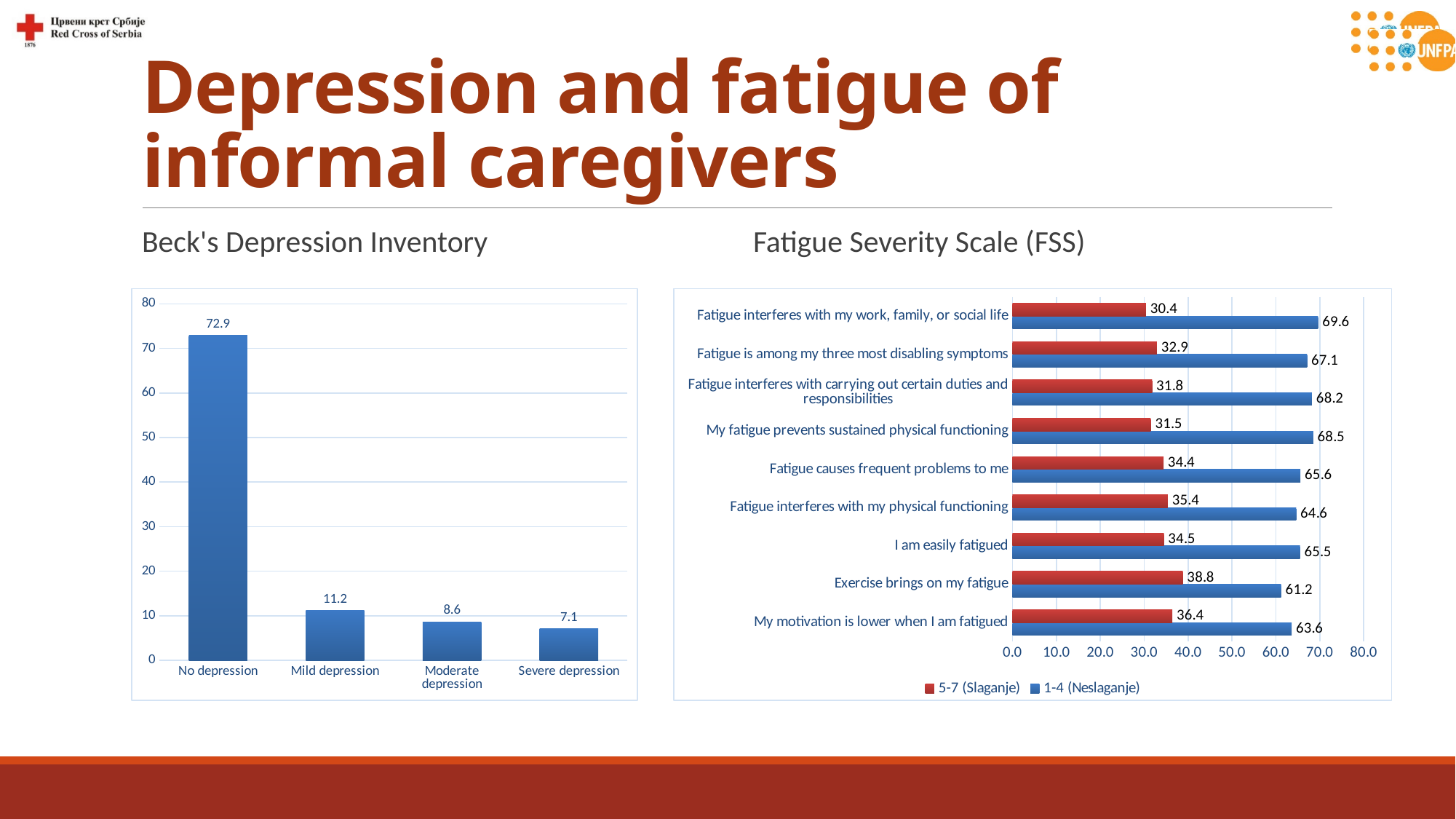
In the Beck's Depression Inventory chart, which category has the lowest value? Severe depression In the Beck's Depression Inventory chart, how many categories are shown? 4 In the Beck's Depression Inventory chart, do the values rise or fall from left to right? fall In the Fatigue Severity Scale (FSS) chart, what is the 1-4 (Neslaganje) value for 'Fatigue interferes with my work, family, or social life'? 69.6 In the Fatigue Severity Scale (FSS) chart, what is the 5-7 (Slaganje) value for 'Exercise brings on my fatigue'? 38.8 In the Fatigue Severity Scale (FSS) chart, how many statements are listed on the vertical axis? 9 In the Beck's Depression Inventory chart, what is the value for No depression? 72.9 In the Beck's Depression Inventory chart, what is the difference between Mild depression and Moderate depression? 2.6 In the Fatigue Severity Scale (FSS) chart, which statement has the highest 5-7 (Slaganje) value? Exercise brings on my fatigue What kind of chart is the Fatigue Severity Scale (FSS) chart? bar chart In the Fatigue Severity Scale (FSS) chart, which is larger for 'I am easily fatigued': the 5-7 (Slaganje) value or the 1-4 (Neslaganje) value? 1-4 (Neslaganje) In the Fatigue Severity Scale (FSS) chart, how many series does the legend list? 2